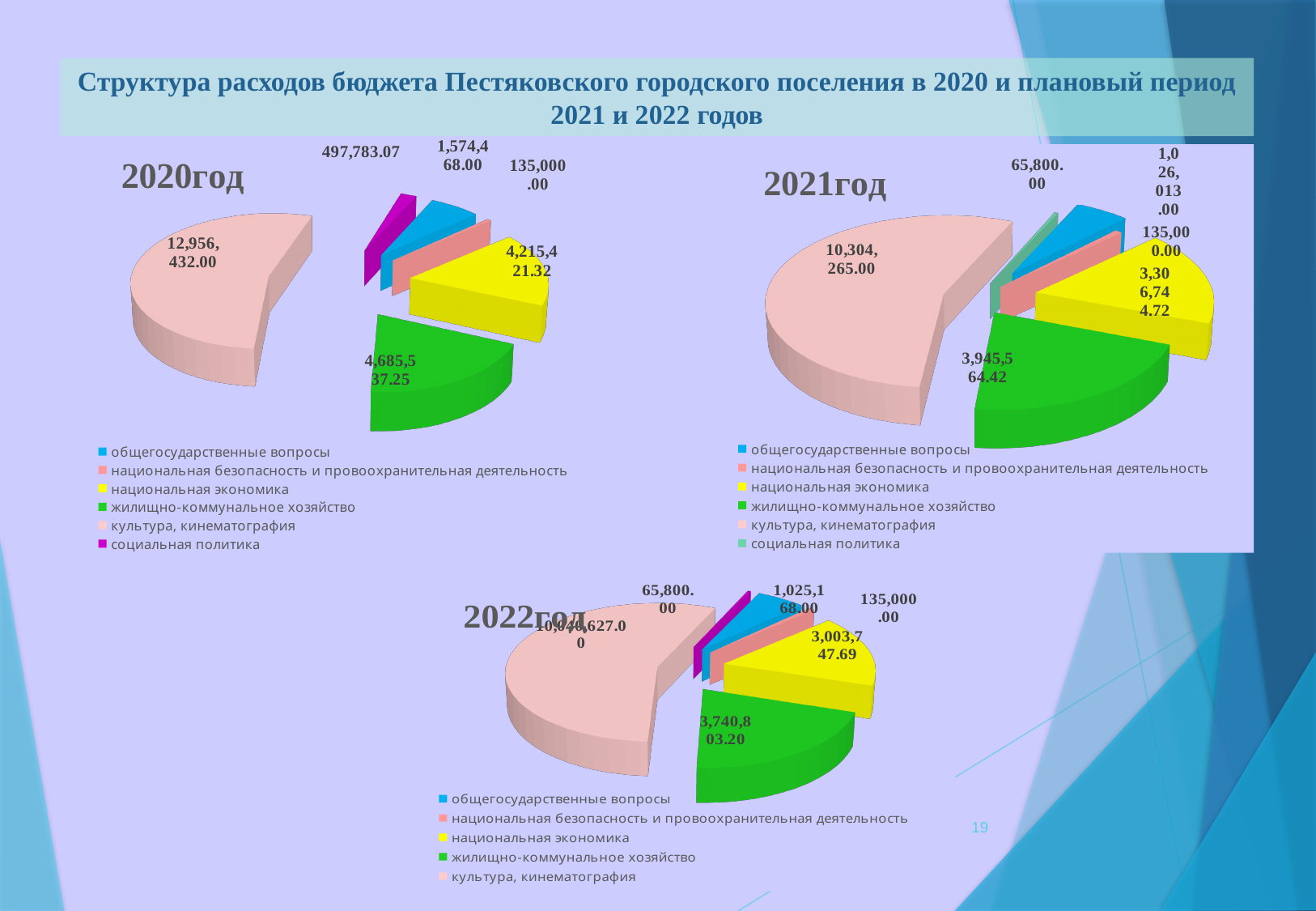
On the 2022год pie chart, what is the value for общегосударственные вопросы? 1,025,168.00 On the 2020год pie chart, what is the difference between жилищно-коммунальное хозяйство and национальная экономика? 470,115.93 How many categories does the legend of the 2022год chart list? 5 On the 2021год pie chart, what is the difference between культура, кинематография and жилищно-коммунальное хозяйство? 6,358,700.58 On the 2021год pie chart, what is the value for социальная политика? 65,800.00 On the 2022год pie chart, what is the value for национальная экономика? 3,003,747.69 On the 2020год pie chart, which is larger: жилищно-коммунальное хозяйство or национальная экономика? жилищно-коммунальное хозяйство On the 2021год pie chart, what is the value for жилищно-коммунальное хозяйство? 3,945,564.42 On the 2020год pie chart, which category has the smallest slice? национальная безопасность и провоохранительная деятельность On the 2020год pie chart, what is the value for культура, кинематография? 12,956,432.00 What kind of chart is used for the 2020год, 2021год and 2022год data? pie chart On the 2020год pie chart, which category has the largest slice? культура, кинематография